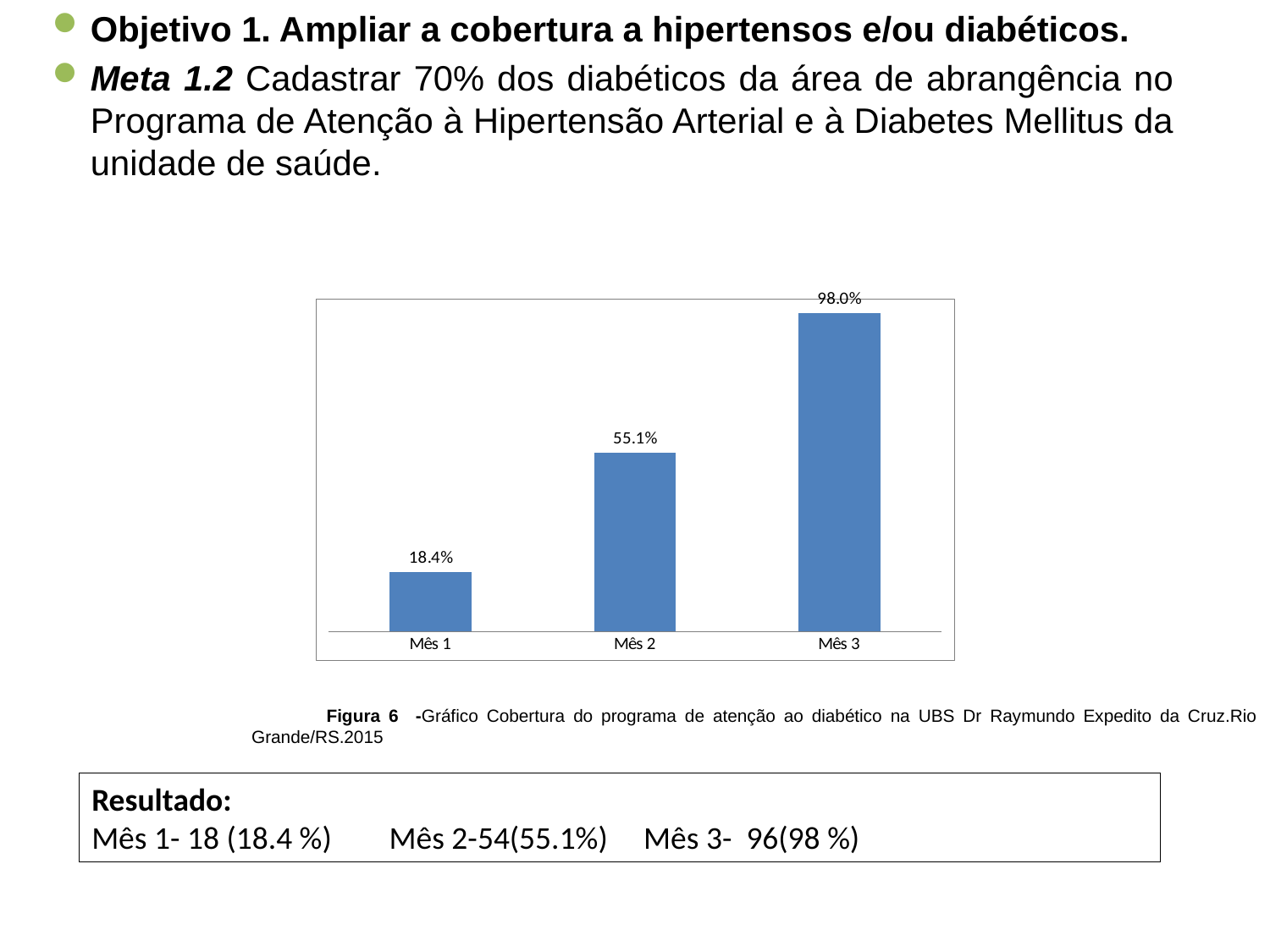
What is the value for Mês 2? 55.1% Do the values rise or fall from Mês 1 to Mês 3? Rise Which is larger, the value for Mês 1 or the value for Mês 2? Mês 2 What is the value for Mês 3? 98.0% What kind of chart is shown on the slide? Bar chart How many categories are shown on the x axis? 3 What is the figure number given in the caption below the chart? Figura 6 Which month has the highest value? Mês 3 What is the difference between the values for Mês 3 and Mês 2? 42.9% What is the difference between the values for Mês 2 and Mês 1? 36.7% Which month has the lowest value? Mês 1 What is the value for Mês 1? 18.4%